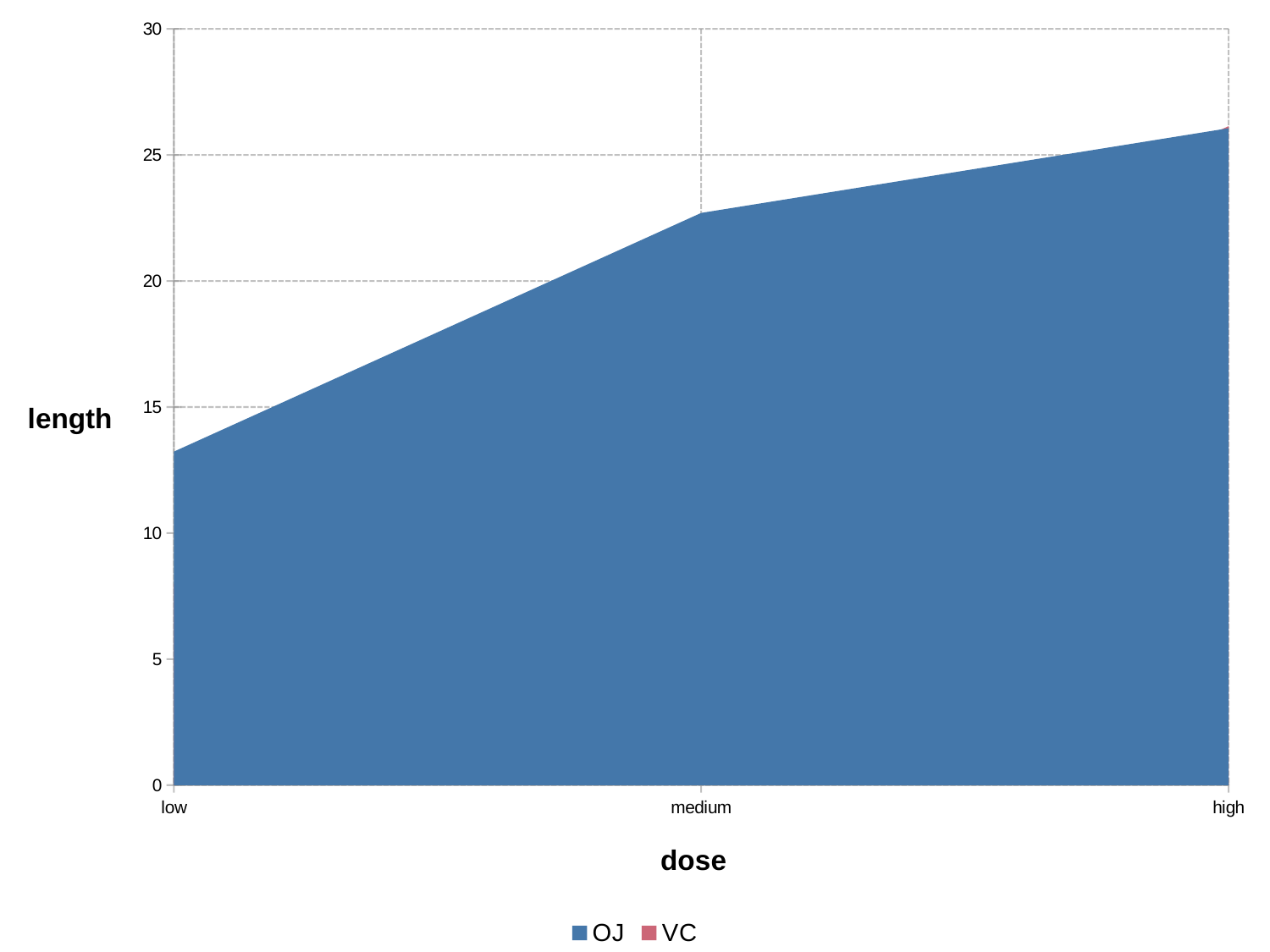
What is the label of the y axis? length Is the OJ value for high dose greater or less than 25? greater Does the OJ value rise or fall as dose goes from low to high? rises Which dose category has the highest OJ value? high Is the OJ value for low dose greater or less than 15? less Is the OJ value for medium dose greater or less than 25? less How many series does the legend list? 2 What kind of chart is shown on the slide? area chart Which is larger, the OJ value for medium dose or for low dose? medium Which dose category has the lowest OJ value? low How many dose categories are shown on the x axis? 3